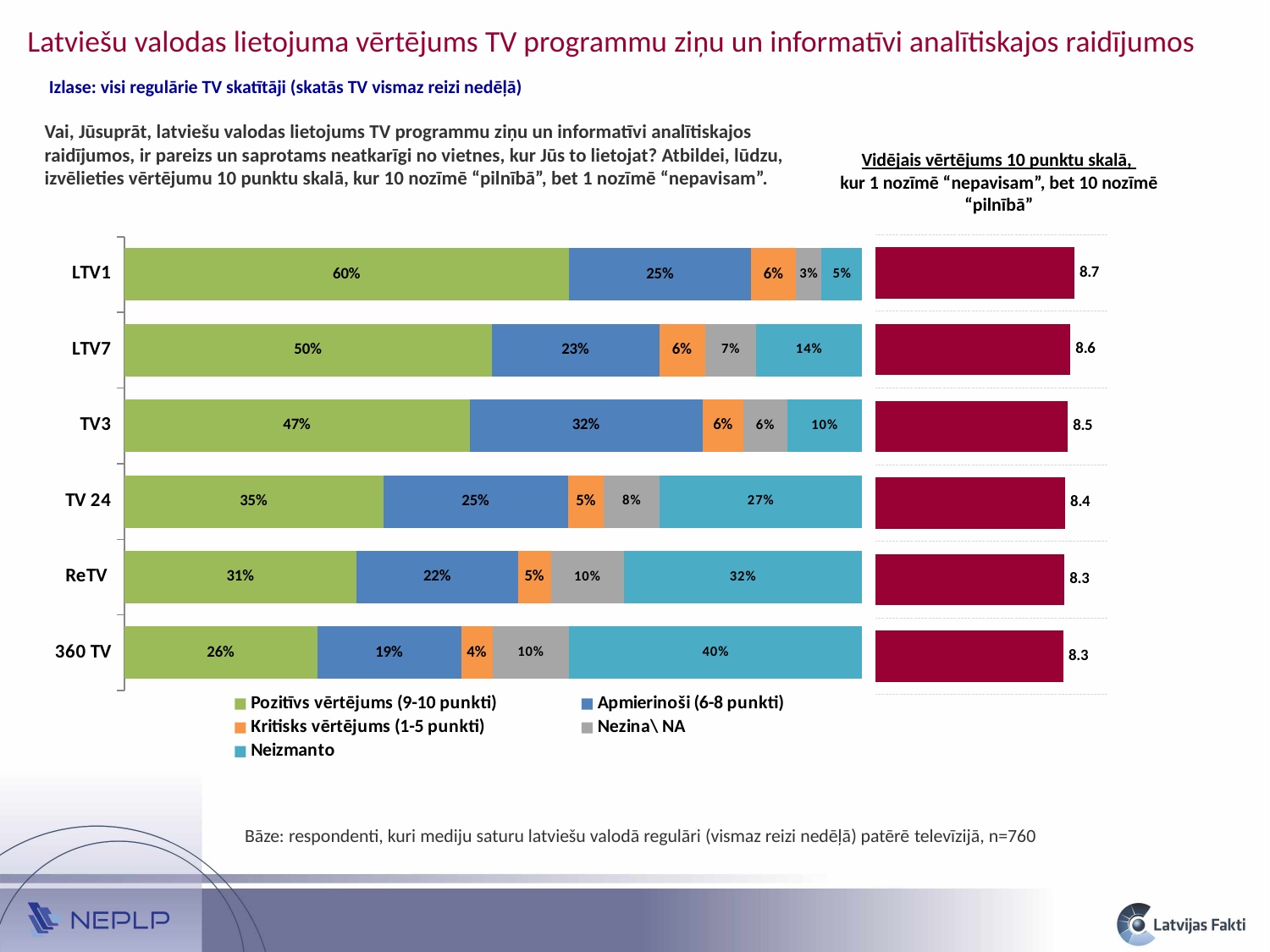
How many series does the legend of the stacked bar chart on the left list? 5 In the right-hand chart (Vidējais vērtējums 10 punktu skalā), what is the average rating for TV3? 8.5 In the right-hand chart (Vidējais vērtējums 10 punktu skalā), which channel has the highest average rating? LTV1 In the stacked bar chart on the left, what is the total of all segments for LTV7? 100% What type of chart is the right-hand chart showing the average ratings? Bar chart In the stacked bar chart on the left, what is the difference in percentage points between the positive rating share for LTV1 and for 360 TV? 34 percentage points In the stacked bar chart on the left, what percentage of LTV1 viewers gave a positive rating (Pozitīvs vērtējums, 9-10 punkti)? 60% How many TV channels are shown in the stacked bar chart on the left? 6 In the stacked bar chart on the left, which channel has the highest share of Neizmanto? 360 TV In the stacked bar chart on the left, which channel has a larger Apmierinoši (6-8 punkti) share, TV3 or TV 24? TV3 In the stacked bar chart on the left, what colour represents Pozitīvs vērtējums (9-10 punkti)? Green In the stacked bar chart on the left, what is the Nezina\ NA share for ReTV? 10%